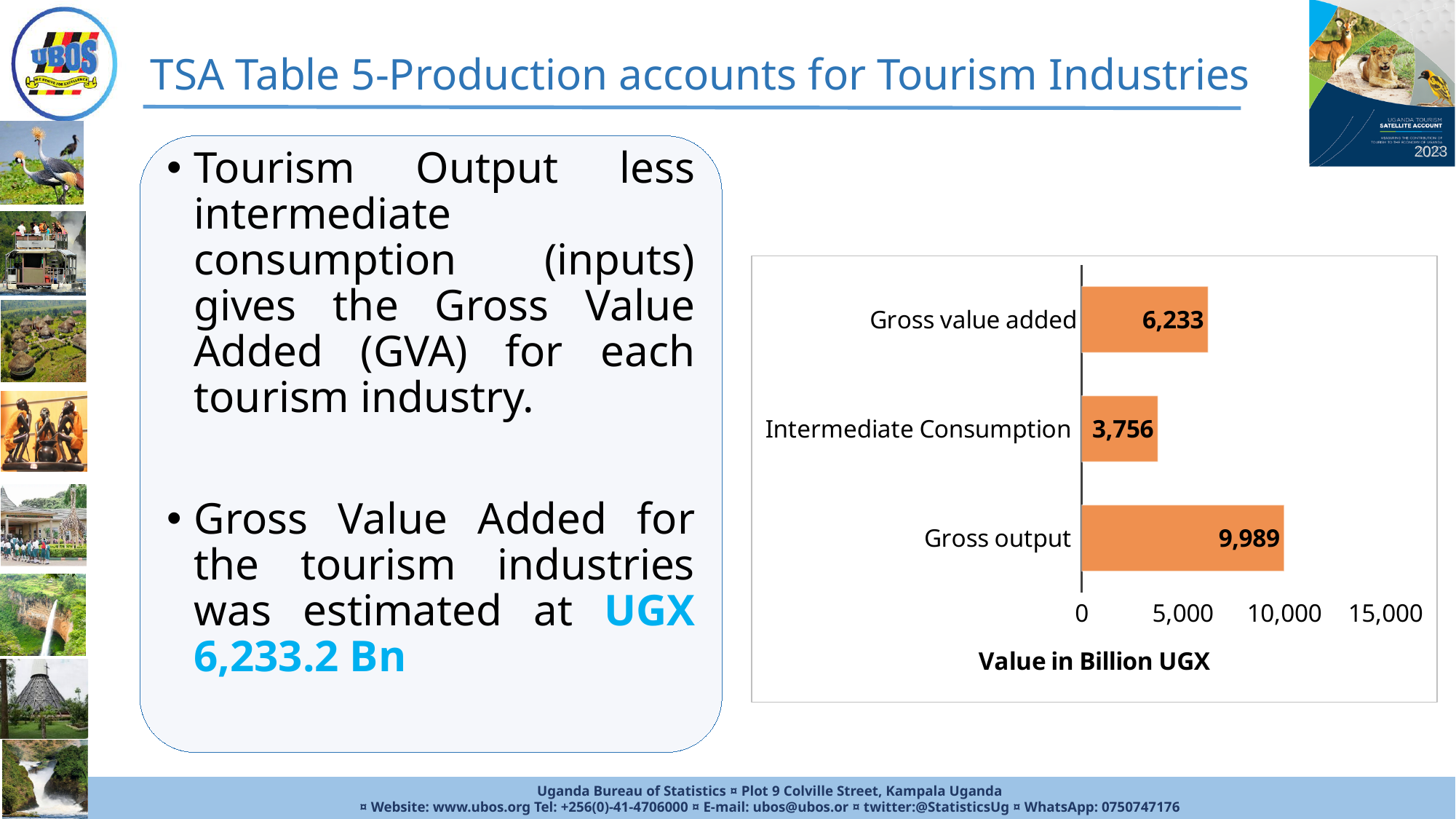
Which is larger, Gross value added or Intermediate Consumption? Gross value added Is the value for Gross output greater or less than 10,000? less What is the difference between Gross value added and Intermediate Consumption? 2,477 Which category has the lowest value? Intermediate Consumption What is the value for Intermediate Consumption? 3,756 What is the difference between Gross output and Gross value added? 3,756 What kind of chart is shown on the slide? bar chart What is the axis title shown below the chart? Value in Billion UGX What is the value for Gross value added? 6,233 How many categories are shown in the chart? 3 What is the value for Gross output? 9,989 Which category has the highest value? Gross output